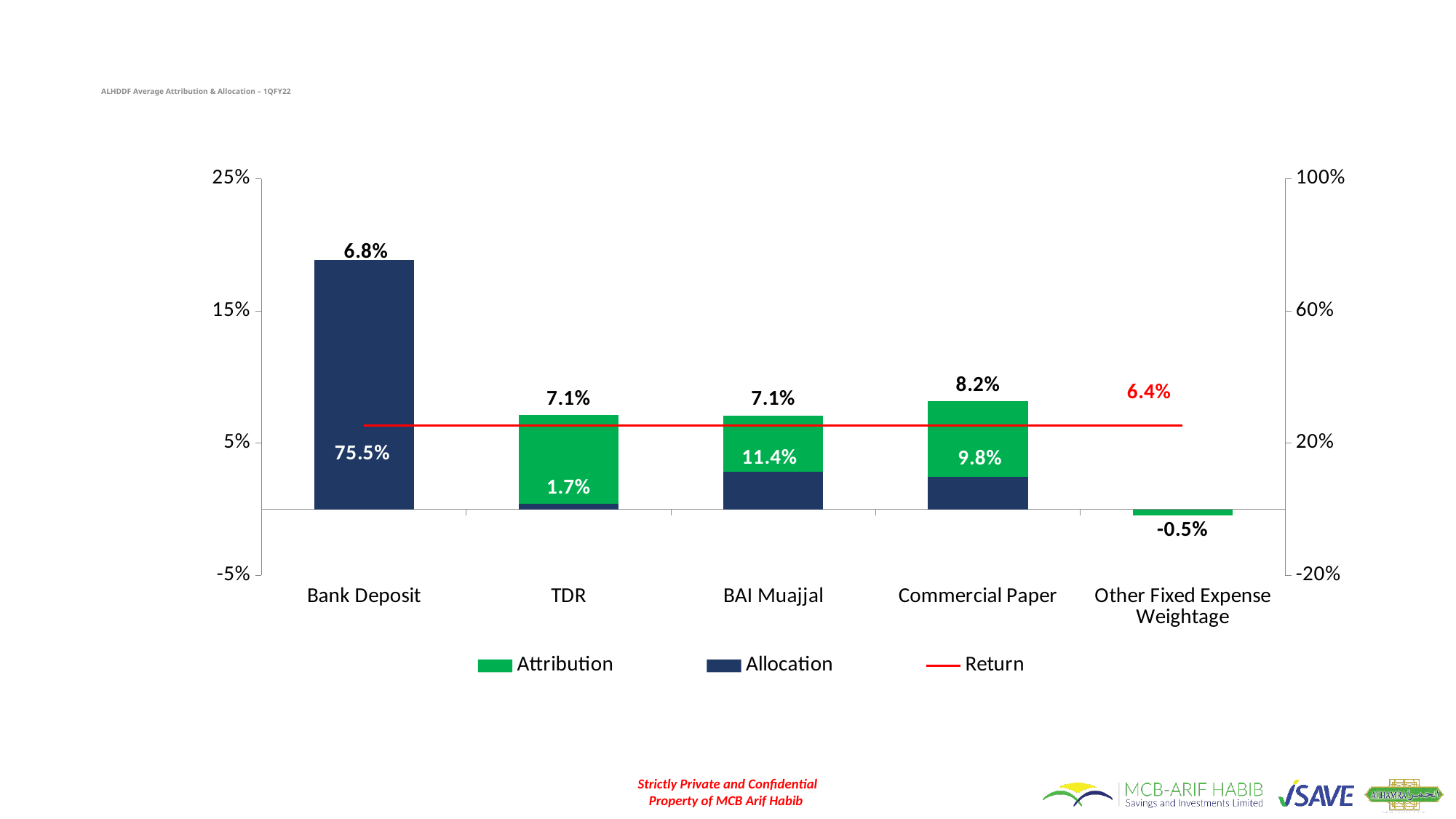
What value is labelled on the Return line? 6.4% How many categories are shown on the x axis? 5 Which category has the highest Attribution value? Commercial Paper What is the Allocation value for BAI Muajjal? 11.4% What is the Allocation value for Bank Deposit? 75.5% Which category has the lowest Allocation value among those labelled? TDR Which is larger, the Allocation value for BAI Muajjal or for Commercial Paper? BAI Muajjal What is the title of the chart? ALHDDF Average Attribution & Allocation – 1QFY22 How many series does the legend list? 3 What is the difference between the Attribution values for Commercial Paper and Bank Deposit? 1.4% What is the Attribution value for Other Fixed Expense Weightage? -0.5% What is the Attribution value for Commercial Paper? 8.2%